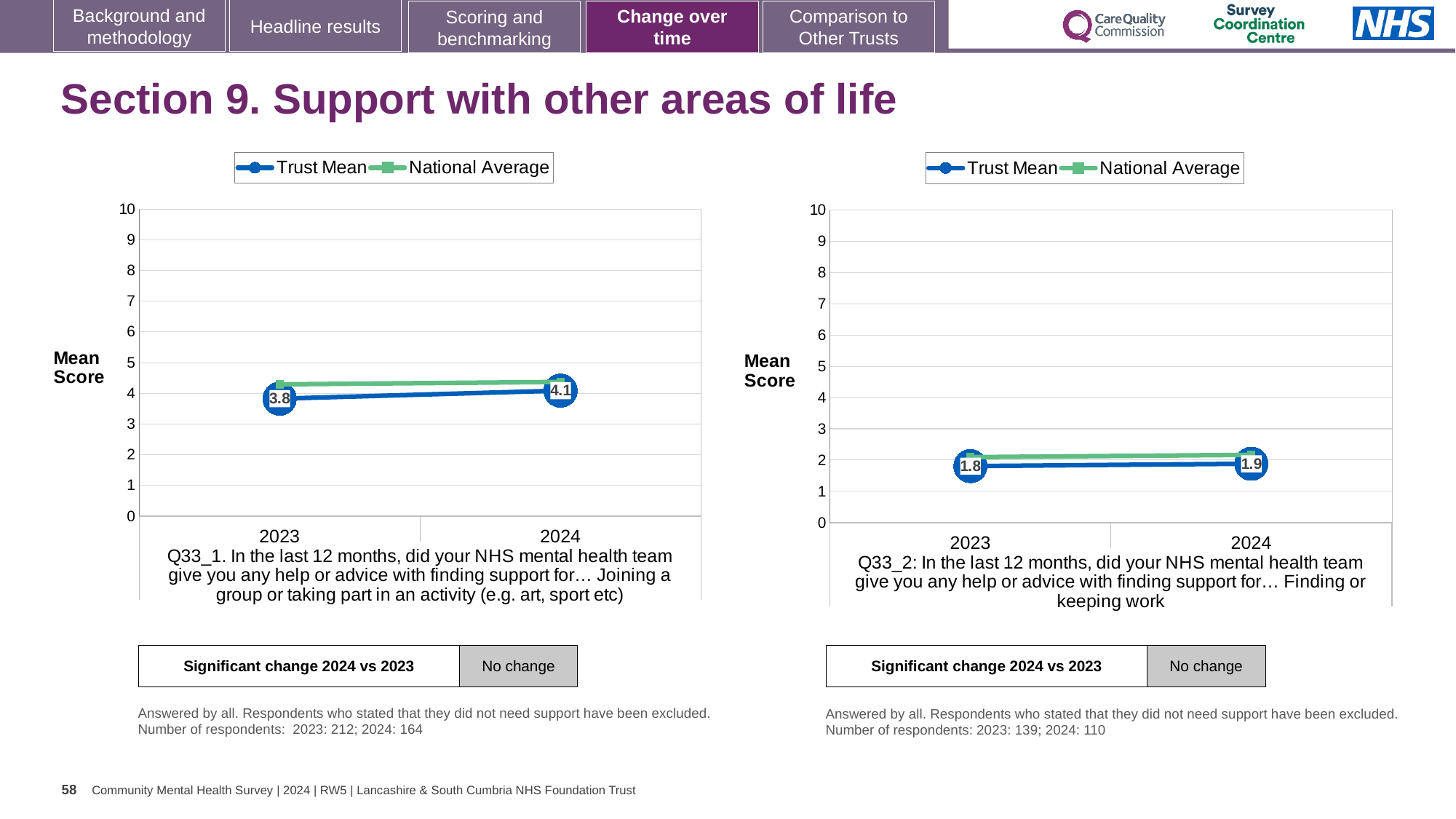
What type of chart is the right chart (Q33_2)? line chart In the left chart (Q33_1), does the Trust Mean rise or fall from 2023 to 2024? rise In the right chart (Q33_2), what is the Trust Mean for 2024? 1.9 In the left chart (Q33_1), is the National Average for 2023 greater or less than 4? greater In the left chart (Q33_1), what is the Trust Mean for 2023? 3.8 In the right chart (Q33_2), what is the difference between the Trust Mean in 2024 and in 2023? 0.1 In the left chart (Q33_1), which is higher in 2023, the Trust Mean or the National Average? National Average In the left chart (Q33_1), what is the Trust Mean for 2024? 4.1 How many years are plotted on the x axis of the right chart (Q33_2)? 2 How many series does the legend of the left chart (Q33_1) list? 2 In the right chart (Q33_2), what is the Trust Mean for 2023? 1.8 In the left chart (Q33_1), by how much did the Trust Mean change from 2023 to 2024? 0.3